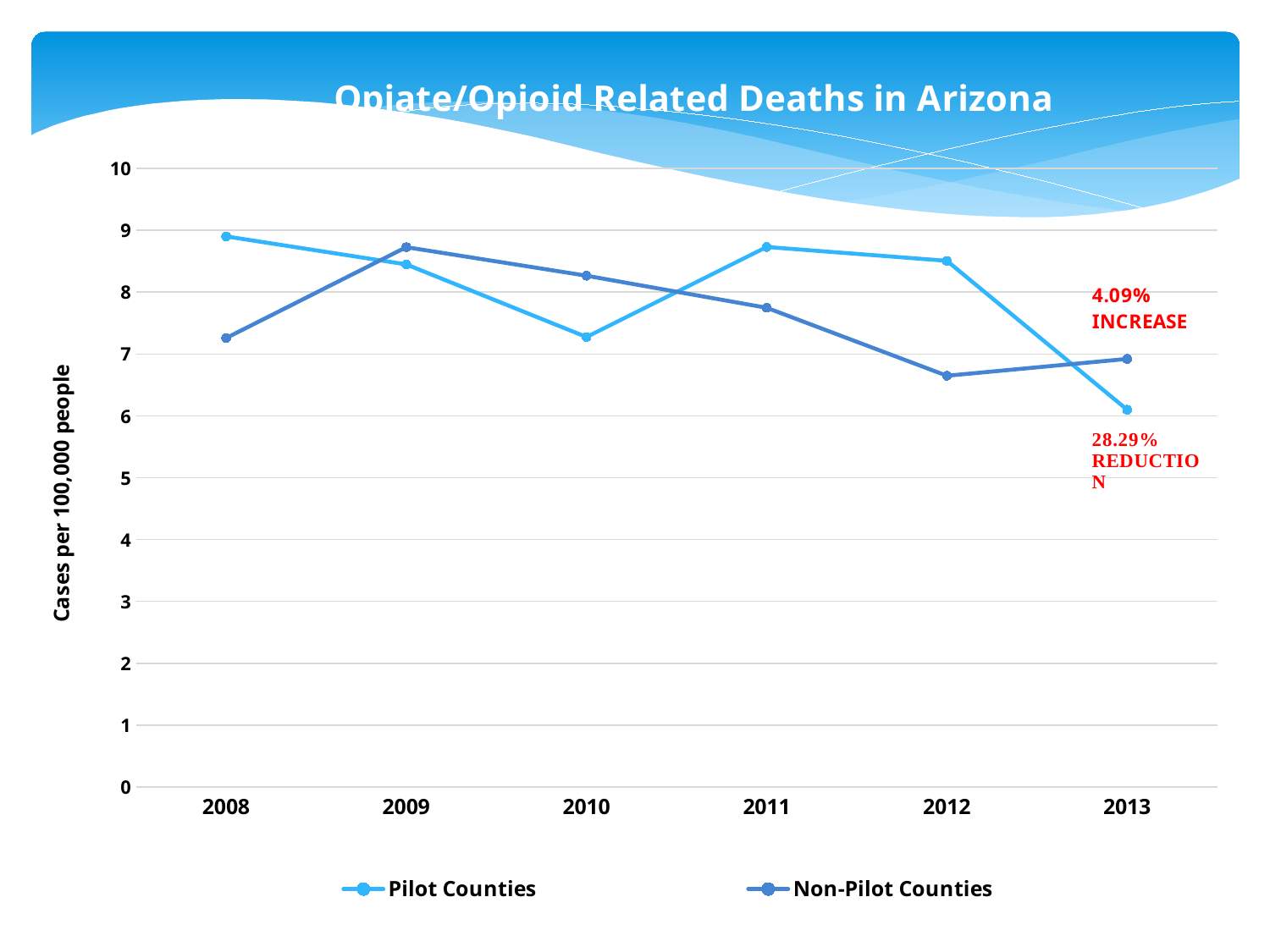
Which year has the highest value for Non-Pilot Counties? 2009 Is the value for Non-Pilot Counties in 2012 greater or less than 7? less Which year has the lowest value for Pilot Counties? 2013 What kind of chart is shown on the slide? Line chart In 2013, which series has the larger value, Pilot Counties or Non-Pilot Counties? Non-Pilot Counties Is the value for Non-Pilot Counties in 2009 greater or less than 8? greater Does the Non-Pilot Counties line rise or fall from 2009 to 2012? Fall Is the value for Pilot Counties in 2013 greater or less than 7? less How many series does the legend list? 2 In 2008, which series has the larger value, Pilot Counties or Non-Pilot Counties? Pilot Counties How many years are shown on the x axis? 6 What percentage reduction is annotated next to the Pilot Counties line at 2013? 28.29%